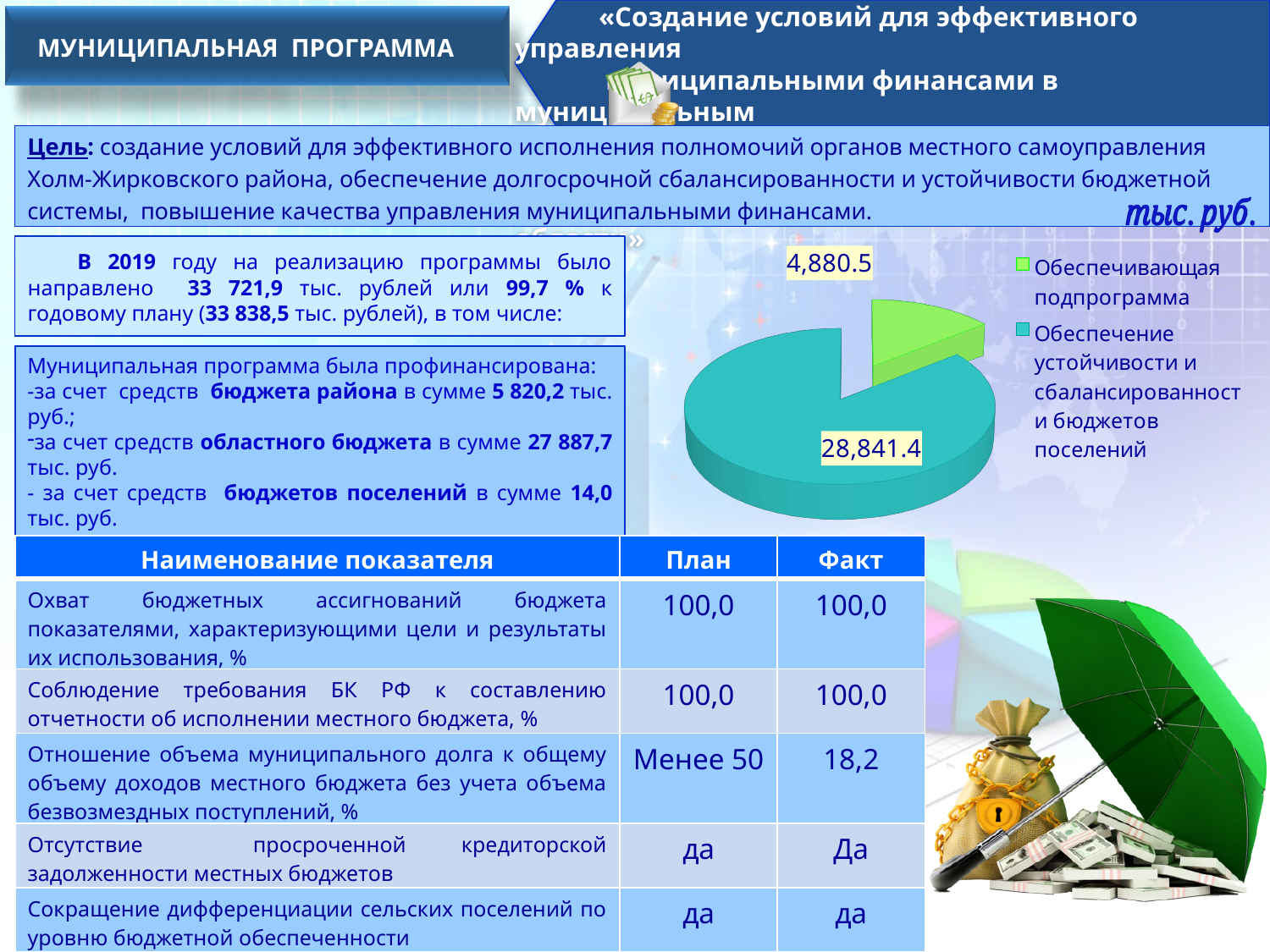
Which is larger in the pie chart: «Обеспечивающая подпрограмма» or «Обеспечение устойчивости и сбалансированности бюджетов поселений»? Обеспечение устойчивости и сбалансированности бюджетов поселений Which category has the smallest slice in the pie chart? Обеспечивающая подпрограмма What unit is indicated for the values in the pie chart? тыс. руб. What is the value of the slice for «Обеспечение устойчивости и сбалансированности бюджетов поселений» in the pie chart? 28,841.4 What kind of chart is shown on the slide? Pie chart What colour is the slice for «Обеспечивающая подпрограмма» in the pie chart? Green What is the total of the two slice values in the pie chart? 33,721.9 What is the value of the slice for «Обеспечивающая подпрограмма» in the pie chart? 4,880.5 What is the difference between the two slice values in the pie chart? 23,960.9 How many slices does the pie chart have? 2 How many entries does the legend of the pie chart list? 2 Which category has the largest slice in the pie chart? Обеспечение устойчивости и сбалансированности бюджетов поселений